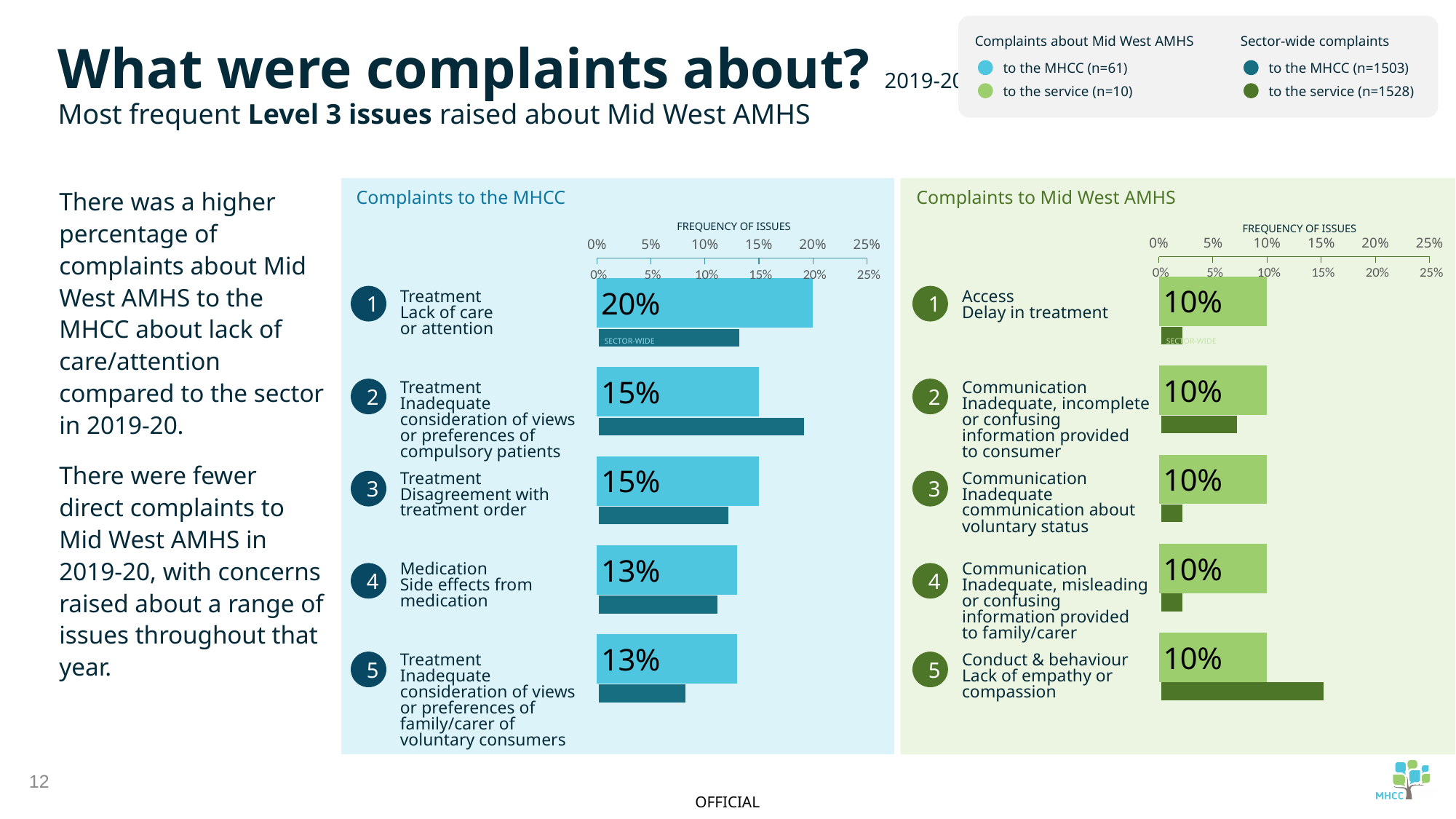
In the 'Complaints to the MHCC' chart, what is the frequency of issues for 'Medication – Side effects from medication'? 13% In the 'Complaints to Mid West AMHS' chart, is the sector-wide bar for 'Access – Delay in treatment' greater or less than 5%? less In the 'Complaints to Mid West AMHS' chart, what is the frequency of issues for 'Access – Delay in treatment'? 10% What type of chart is used in the 'Complaints to the MHCC' panel? Bar chart In the 'Complaints to the MHCC' chart, what is the difference between the frequency for 'Treatment – Lack of care or attention' and 'Medication – Side effects from medication'? 7 percentage points In the 'Complaints to the MHCC' chart, which issue has the highest frequency? Treatment – Lack of care or attention In the 'Complaints to the MHCC' chart, what is the frequency of issues for 'Treatment – Lack of care or attention'? 20% In the 'Complaints to the MHCC' chart, for 'Treatment – Lack of care or attention', which bar is larger: the Mid West AMHS bar or the sector-wide bar? Mid West AMHS bar In the 'Complaints to the MHCC' chart, is the sector-wide bar for 'Treatment – Inadequate consideration of views or preferences of compulsory patients' greater or less than 15%? greater How many issues are listed in the 'Complaints to the MHCC' chart? 5 According to the legend, how many complaints about Mid West AMHS were made to the MHCC? n=61 In the 'Complaints to Mid West AMHS' chart, is the sector-wide bar for 'Conduct & behaviour – Lack of empathy or compassion' greater or less than 10%? greater